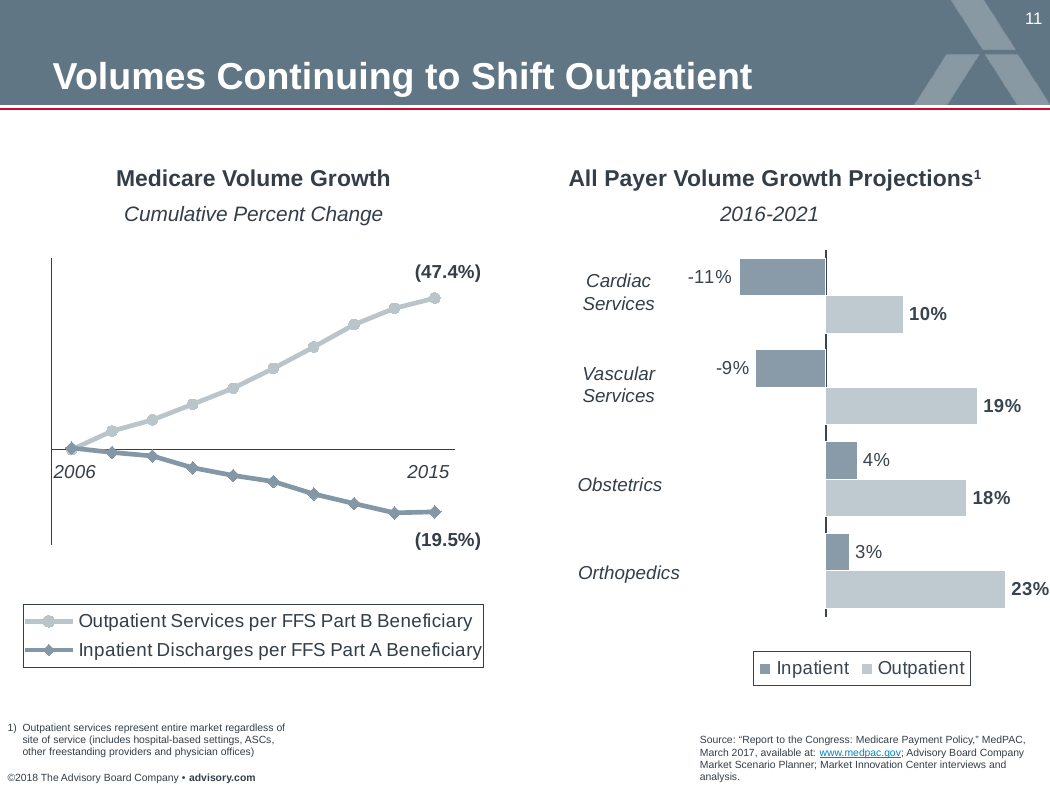
In the Medicare Volume Growth chart, how many series does the legend list? 2 In the All Payer Volume Growth Projections chart, what is the Inpatient value for Cardiac Services? -11% In the All Payer Volume Growth Projections chart, what is the difference between the Outpatient and Inpatient values for Obstetrics? 14% In the All Payer Volume Growth Projections chart, which category has the highest Outpatient value? Orthopedics What kind of chart is the Medicare Volume Growth chart? Line chart In the Medicare Volume Growth chart, what is the final cumulative percent change for Outpatient Services per FFS Part B Beneficiary? (47.4%) In the Medicare Volume Growth chart, does the Inpatient Discharges per FFS Part A Beneficiary line rise or fall from 2006 to 2015? Fall In the Medicare Volume Growth chart, does the Outpatient Services per FFS Part B Beneficiary line rise or fall from 2006 to 2015? Rise In the Medicare Volume Growth chart, what is the final cumulative percent change for Inpatient Discharges per FFS Part A Beneficiary? (19.5%) In the All Payer Volume Growth Projections chart, what is the Outpatient value for Orthopedics? 23% In the All Payer Volume Growth Projections chart, how many categories are shown? 4 In the All Payer Volume Growth Projections chart, which category has the lowest Inpatient value? Cardiac Services